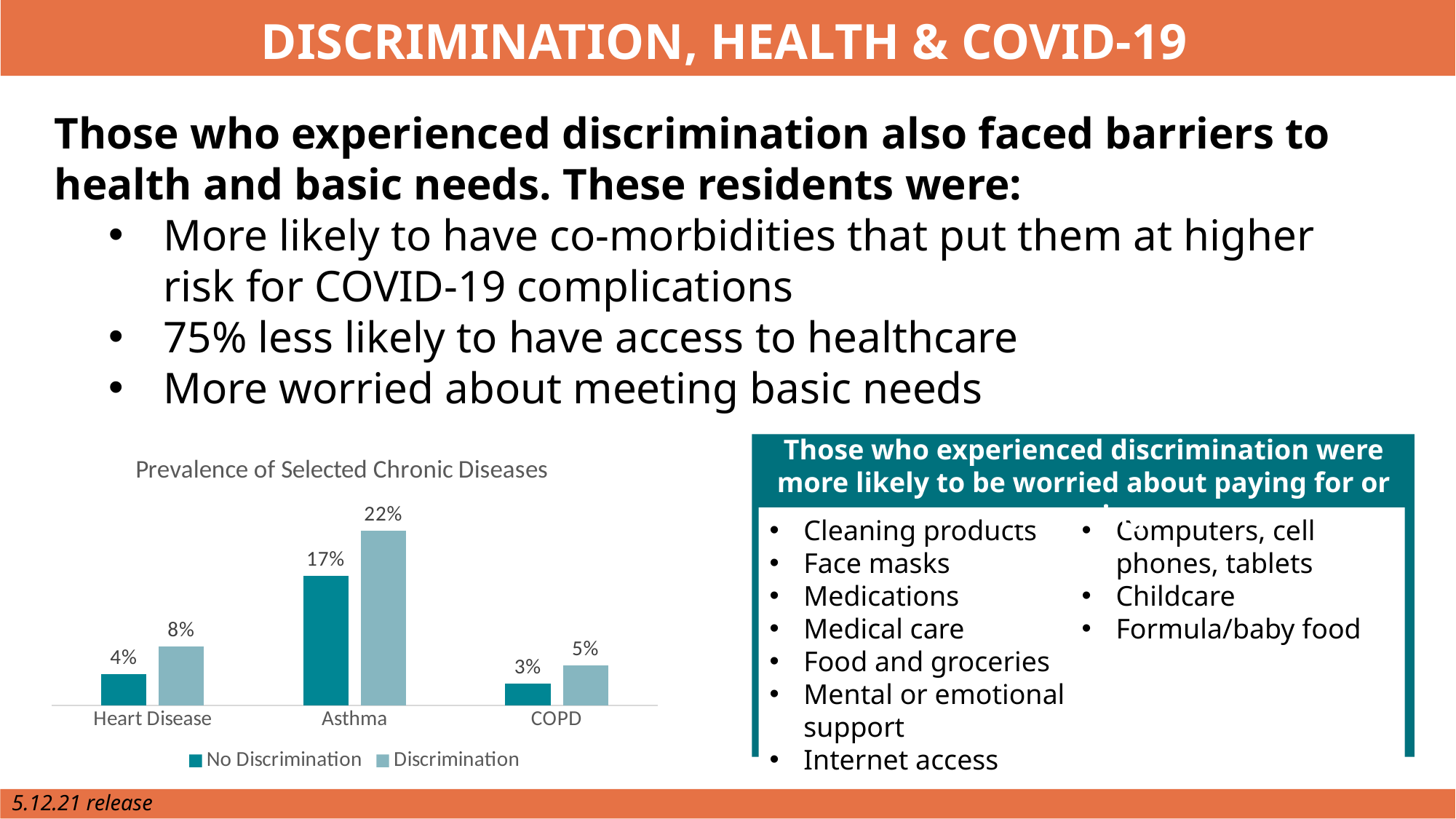
What is the difference between the Discrimination and No Discrimination values for asthma? 5% For COPD, which series has the larger value: No Discrimination or Discrimination? Discrimination What is the title of the chart on the slide? Prevalence of Selected Chronic Diseases What is the difference between the Discrimination and No Discrimination values for heart disease? 4% Which chronic disease has the highest prevalence in the Discrimination series? Asthma What is the COPD value for the Discrimination series? 5% How many series does the chart legend list? 2 What is the prevalence of heart disease among those with no discrimination? 4% What is the prevalence of asthma among those who experienced discrimination? 22% Which chronic disease has the lowest prevalence in the No Discrimination series? COPD What type of chart is used to show the prevalence of selected chronic diseases? Bar chart How many chronic disease categories are shown on the x axis of the chart? 3